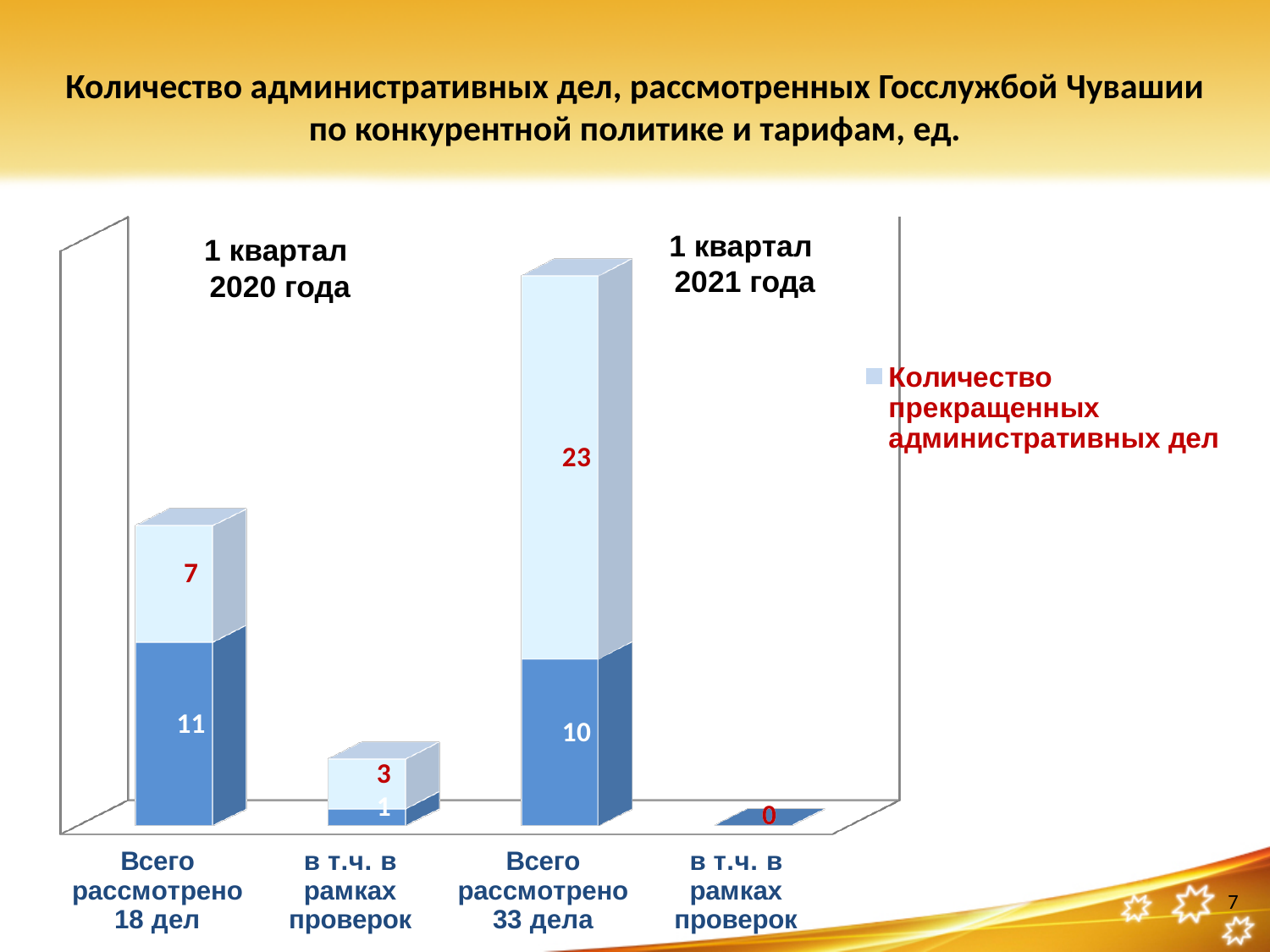
What is the number of terminated administrative cases for "в т.ч. в рамках проверок" in 1 квартал 2020 года? 3 What is the number of terminated administrative cases for the category "Всего рассмотрено 33 дела"? 23 What kind of chart is shown on the slide? Stacked bar chart What is the value of the dark blue segment for the category "Всего рассмотрено 33 дела"? 10 What is the number of terminated administrative cases for "в т.ч. в рамках проверок" in 1 квартал 2021 года? 0 What is the total of the stacked bar for "Всего рассмотрено 18 дел"? 18 What is the number of terminated administrative cases (Количество прекращенных административных дел) for the category "Всего рассмотрено 18 дел"? 7 How many more terminated administrative cases were there in "Всего рассмотрено 33 дела" than in "Всего рассмотрено 18 дел"? 16 Which category has the tallest stacked bar? Всего рассмотрено 33 дела How many categories are shown on the x axis of the chart? 4 What is the total of the stacked bar for "Всего рассмотрено 33 дела"? 33 What is the value of the dark blue segment for the category "Всего рассмотрено 18 дел"? 11